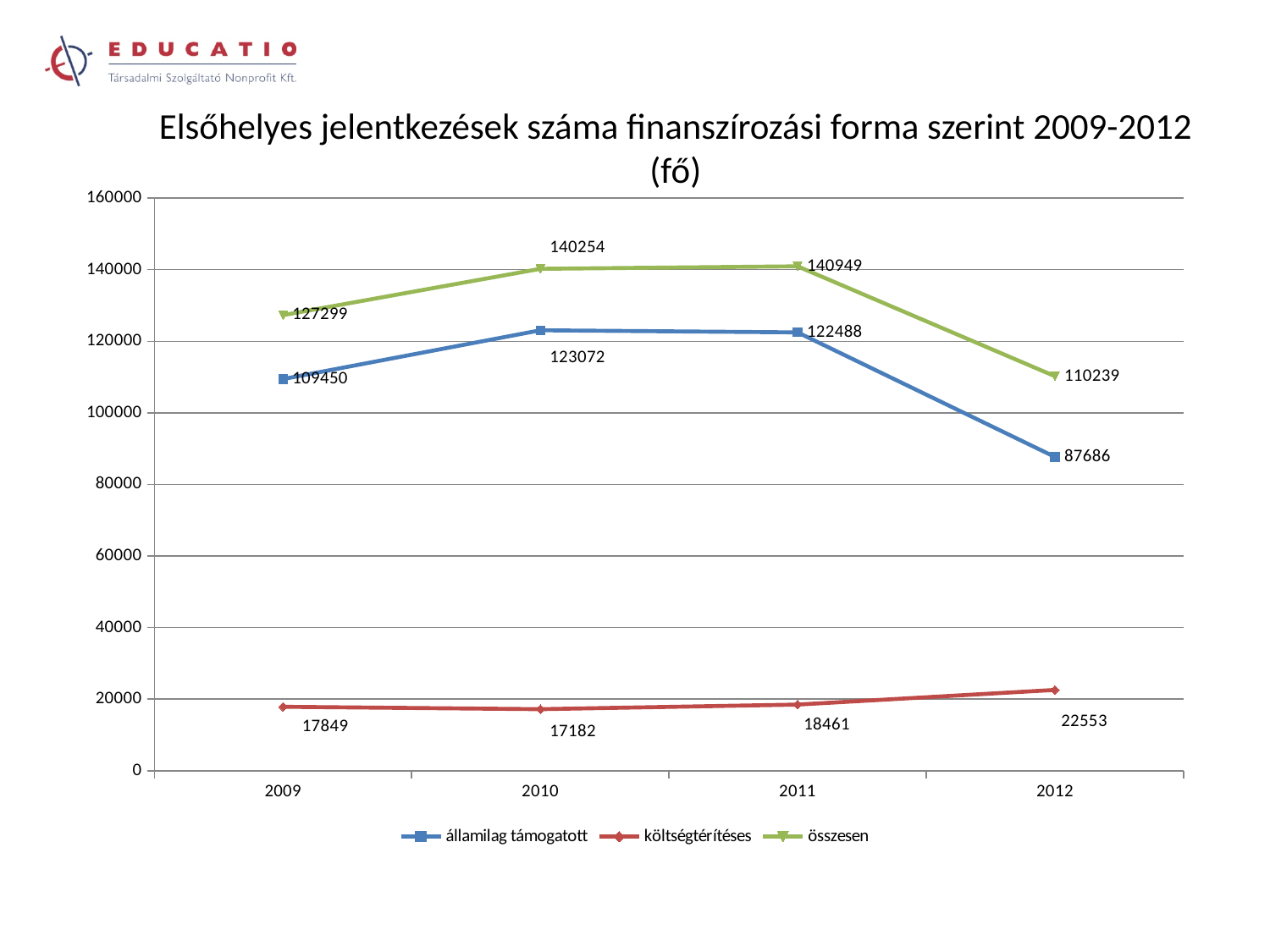
How many years are shown on the x axis? 4 In which year is the 'összesen' series highest? 2011 Which is larger: the 'államilag támogatott' value in 2009 or in 2012? 2009 What is the value for 'költségtérítéses' in 2012? 22553 What is the difference between the 'államilag támogatott' values in 2011 and 2012? 34802 What is the value for 'államilag támogatott' in 2010? 123072 Does the 'államilag támogatott' series rise or fall from 2011 to 2012? fall What is the value for 'összesen' in 2009? 127299 What type of chart is shown on the slide? line chart Is the 'összesen' value for 2012 greater or less than 100000? greater How many series does the legend list? 3 In which year is the 'költségtérítéses' series lowest? 2010